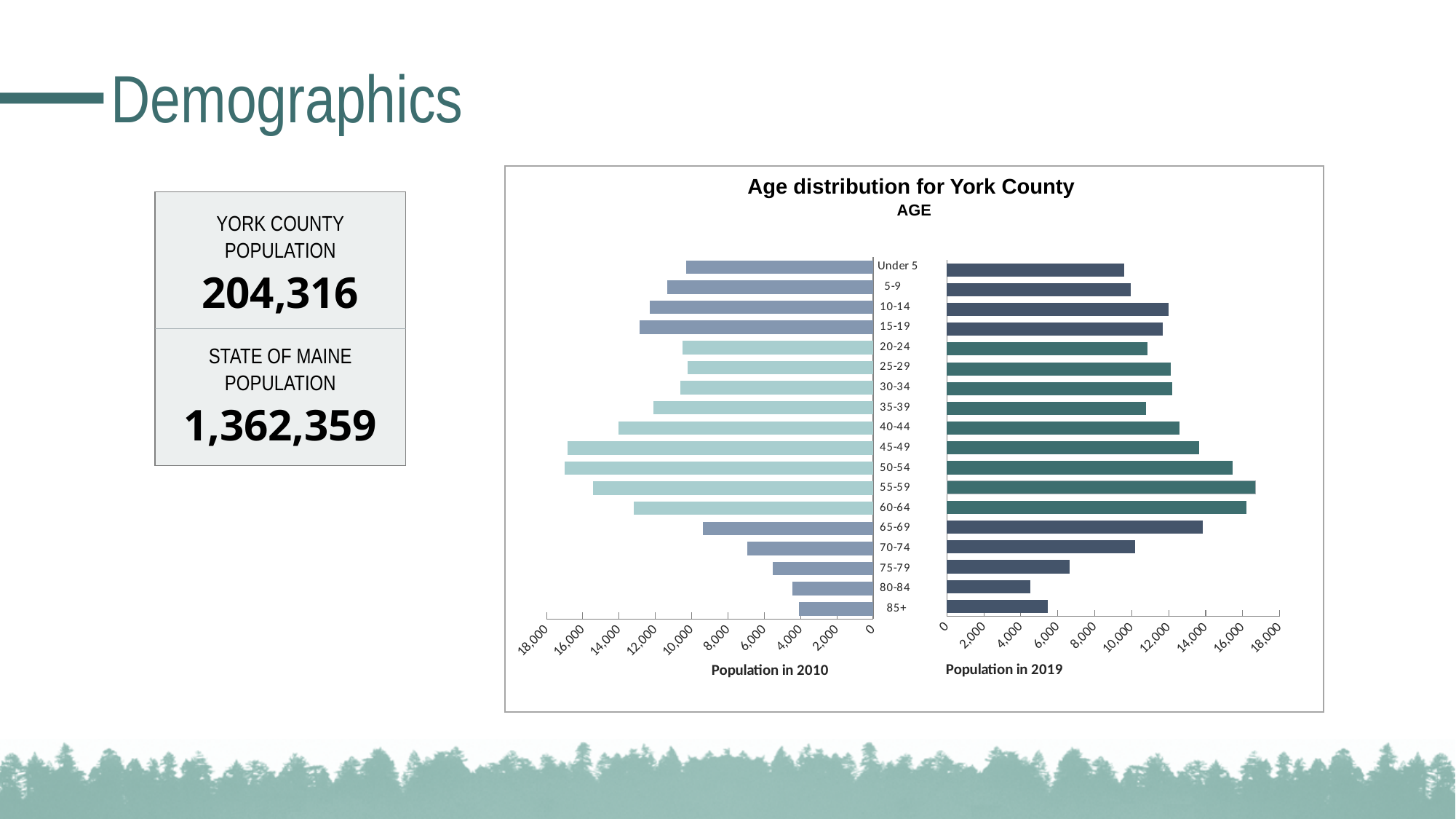
Is the Population in 2019 for the 75-79 age group greater or less than 8,000? less Which age group has the lowest Population in 2019? 80-84 Is the Population in 2010 for the 85+ age group greater or less than 6,000? less What are the two population years compared in the chart? 2010 and 2019 Is the Population in 2010 for the 45-49 age group greater or less than 14,000? greater What is the title of the chart? Age distribution for York County Which age group has the highest Population in 2019? 55-59 What kind of chart is shown on the slide? bar chart How many age groups are plotted in the chart? 18 Which has the larger Population in 2019: the 55-59 age group or the Under 5 age group? 55-59 Which has the larger Population in 2010: the 15-19 age group or the 85+ age group? 15-19